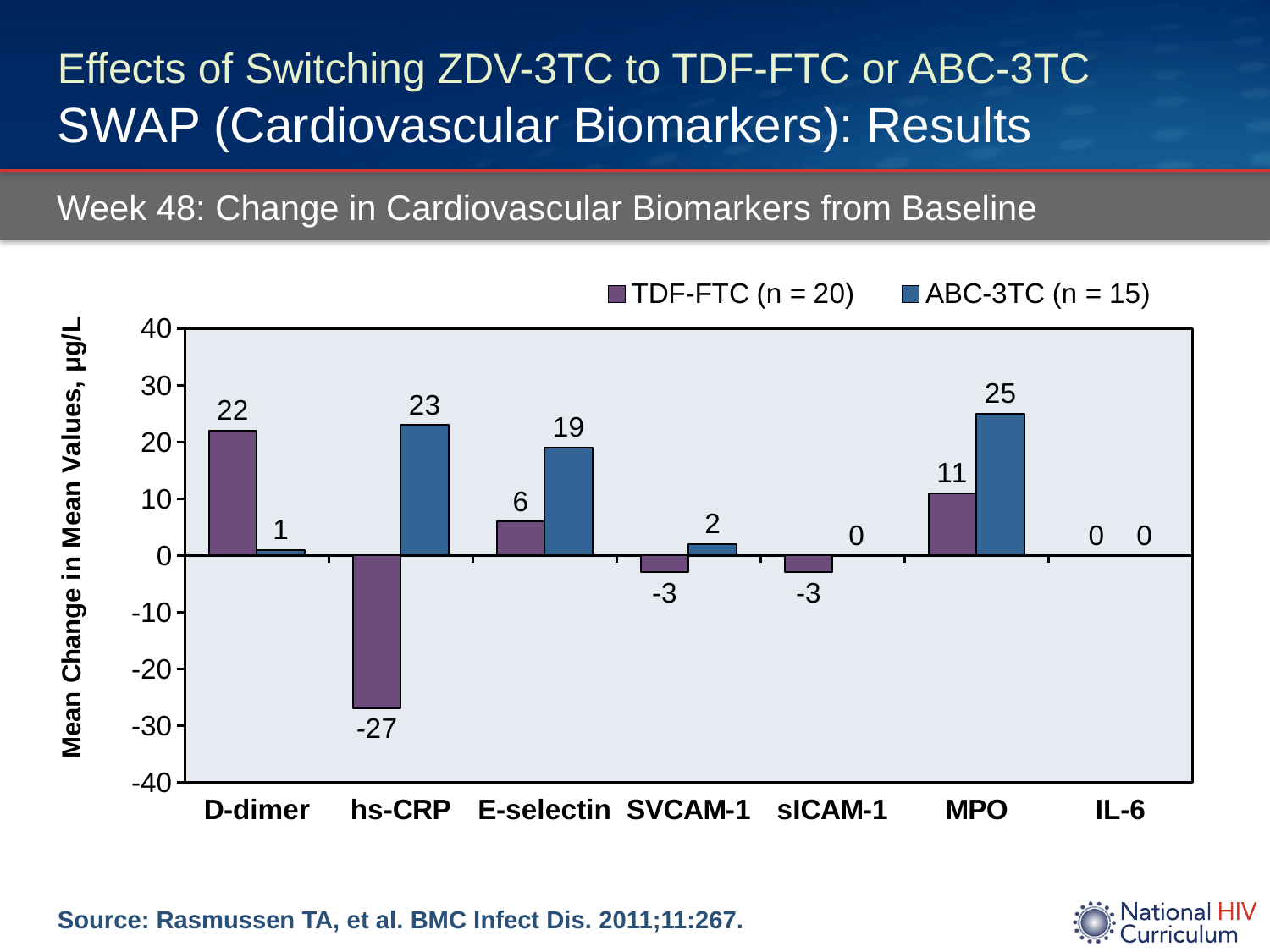
How many biomarkers are shown on the x axis? 7 What is the label of the y axis? Mean Change in Mean Values, µg/L For MPO, which group has the larger mean change, TDF-FTC or ABC-3TC? ABC-3TC What is the mean change in MPO for the ABC-3TC (n = 15) group? 25 What is the mean change in hs-CRP for the TDF-FTC (n = 20) group? -27 Which biomarker has the lowest mean change for the TDF-FTC (n = 20) group? hs-CRP What kind of chart is shown on the slide? Bar chart What is the mean change in E-selectin for the ABC-3TC (n = 15) group? 19 How many series does the legend list? 2 What is the mean change in D-dimer for the TDF-FTC (n = 20) group? 22 Which biomarker has the highest mean change for the ABC-3TC (n = 15) group? MPO What is the difference between the TDF-FTC and ABC-3TC mean changes for D-dimer? 21